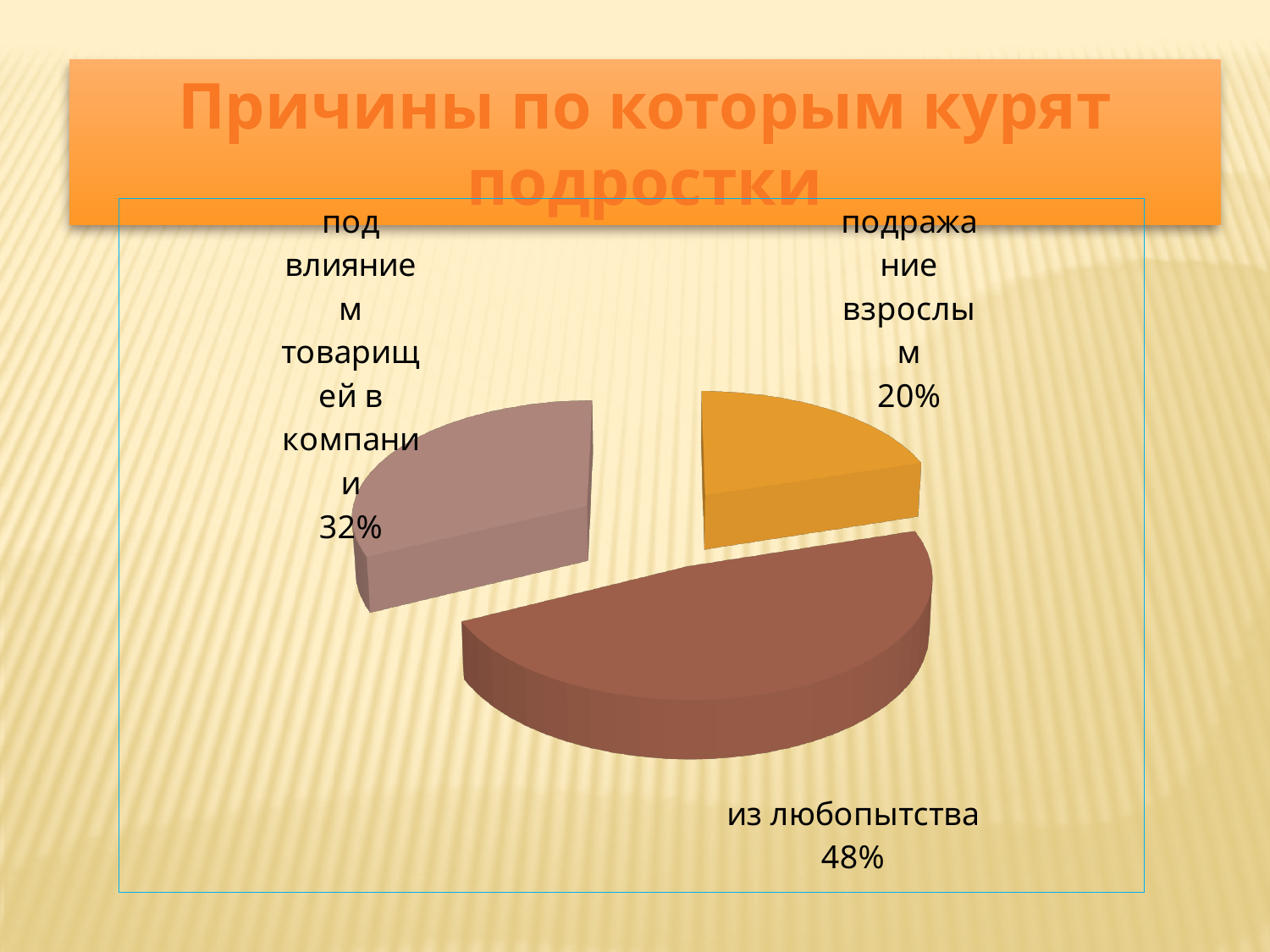
What kind of chart is shown on the slide? pie chart What is the title of the slide containing the chart? Причины по которым курят подростки What colour is the slice for "подражание взрослым"? yellow/orange What share of the pie is labelled "под влиянием товарищей в компании"? 32% What share of the pie is labelled "из любопытства"? 48% Which is larger: the share for "подражание взрослым" or the share for "под влиянием товарищей в компании"? под влиянием товарищей в компании What share of the pie is labelled "подражание взрослым"? 20% Which reason has the smallest share of the pie? подражание взрослым Which reason has the largest share of the pie? из любопытства What is the difference in percentage points between "из любопытства" and "под влиянием товарищей в компании"? 16 How many slices does the pie chart have? 3 What is the difference in percentage points between "под влиянием товарищей в компании" and "подражание взрослым"? 12